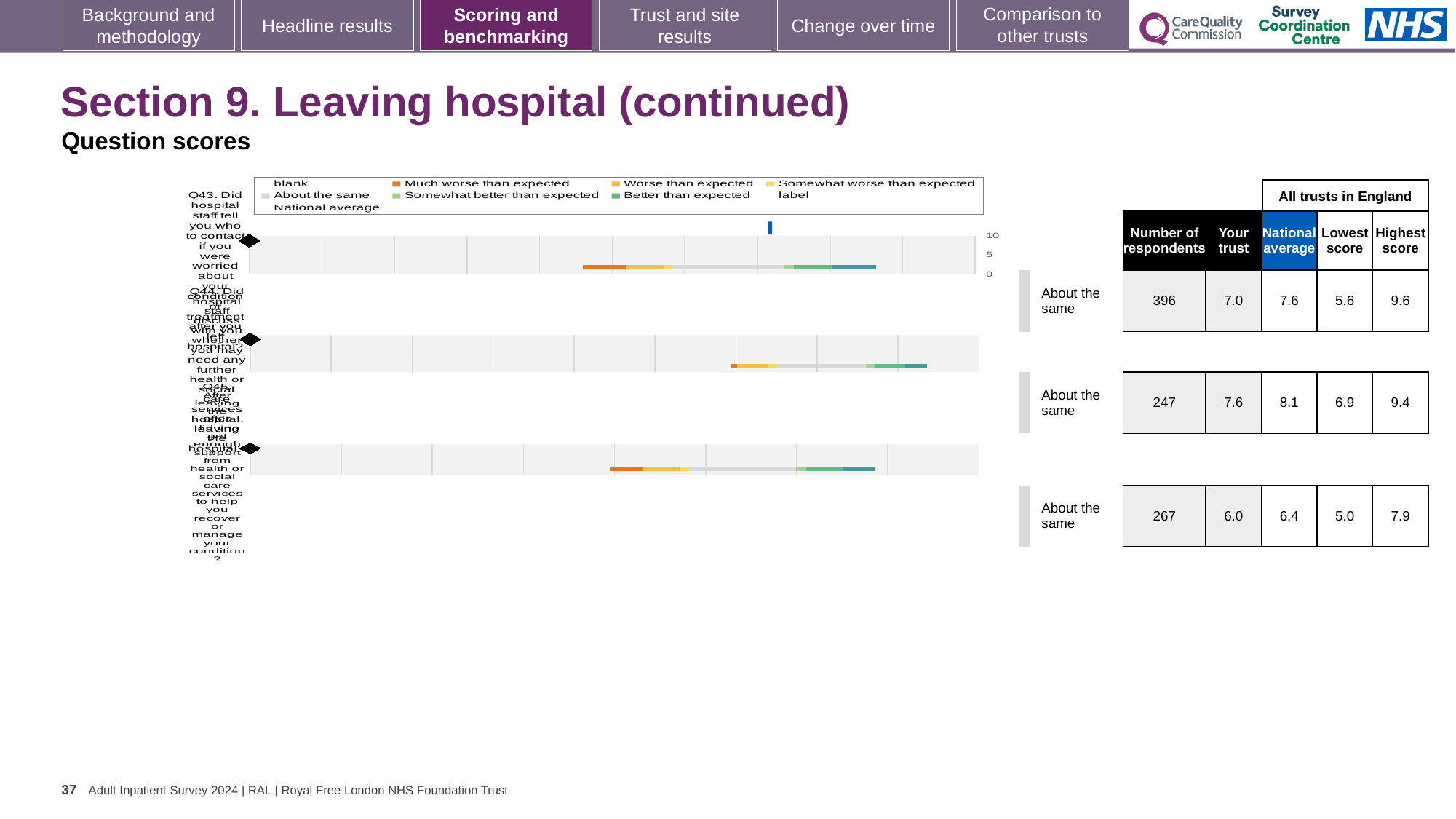
What kind of chart is used to show the Q43 benchmark result? bar chart For the first chart (Q43), what is the difference between the highest score and the lowest score across all trusts in England? 4.0 For the first chart (Q43), is the 'Your trust' score higher or lower than the national average? lower For the second chart, what is the highest score across all trusts in England? 9.4 How many question charts are shown on the slide? 3 Which of the three charts has the highest 'Your trust' score? the second chart For the first chart (Q43), what is the national average score? 7.6 For the third chart, how many respondents are listed? 267 For the first chart (Q43), how many respondents are listed? 396 What benchmark category is shown beside the first chart (Q43)? About the same For the first chart (Q43), what is the 'Your trust' score? 7.0 What is the highest tick value shown on the chart axis? 10